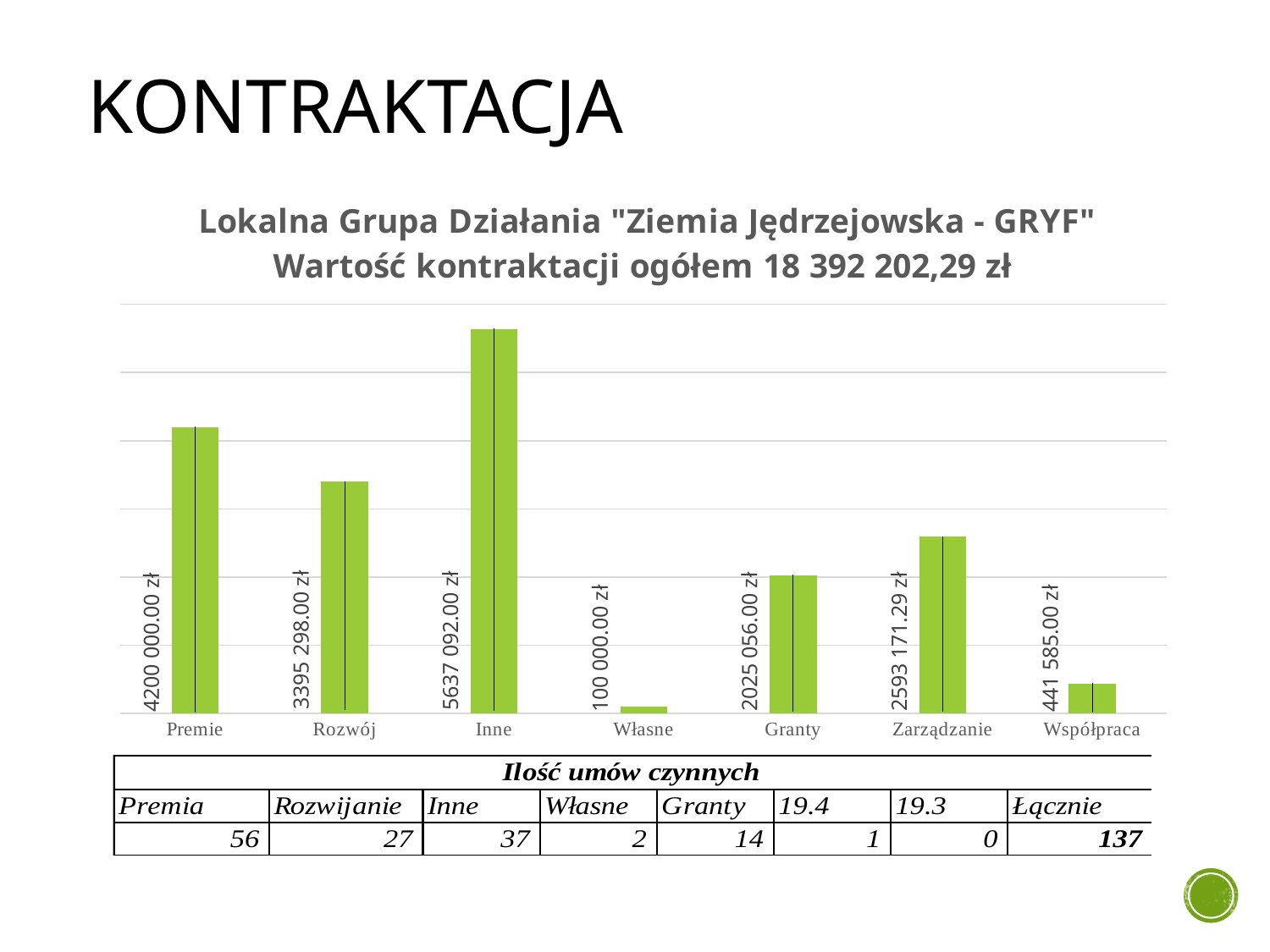
What is the difference between the values for Inne and Premie? 1437 092.00 zł What kind of chart is shown? bar chart Which category has the highest value? Inne What is the value for Inne? 5637 092.00 zł Which is larger, the value for Granty or the value for Zarządzanie? Zarządzanie What is the value for Współpraca? 441 585.00 zł Which category has the lowest value? Własne How many categories are shown on the x axis? 7 What is the value for Zarządzanie? 2593 171.29 zł What is the value for Własne? 100 000.00 zł What total contract value is stated in the chart title? 18 392 202,29 zł What is the difference between the values for Premie and Rozwój? 804 702.00 zł